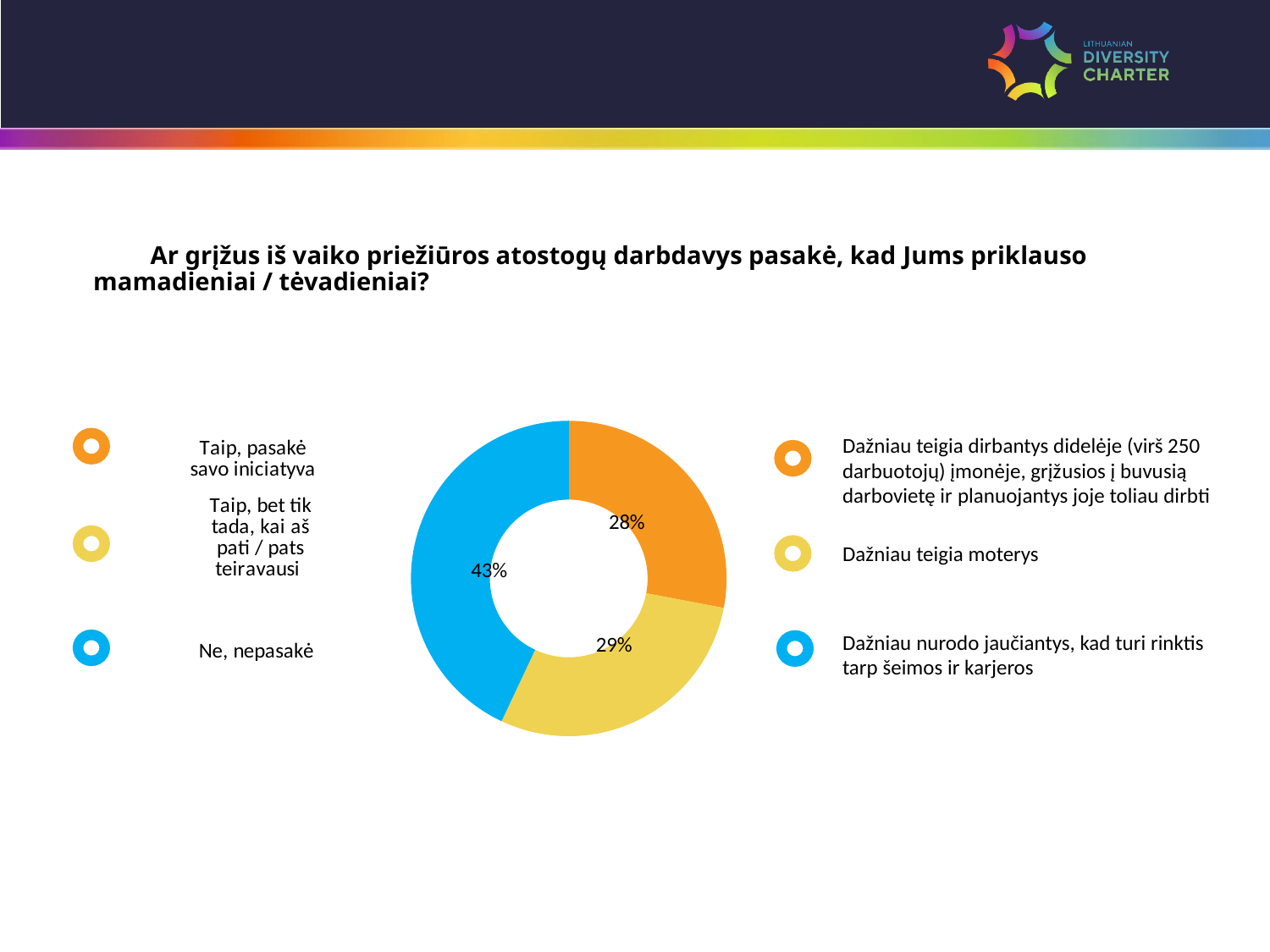
What is the difference in percentage points between "Ne, nepasakė" and "Taip, pasakė savo iniciatyva"? 15 percentage points What percentage of respondents answered "Ne, nepasakė"? 43% What percentage of respondents answered "Taip, pasakė savo iniciatyva"? 28% Which colour represents the "Taip, pasakė savo iniciatyva" category in the chart? Orange What is the combined share of the two "Taip" answers (28% and 29%)? 57% Which answer category has the smallest share of the chart? Taip, pasakė savo iniciatyva Which is larger: the share for "Ne, nepasakė" or the share for "Taip, bet tik tada, kai aš pati / pats teiravausi"? Ne, nepasakė What percentage of respondents answered "Taip, bet tik tada, kai aš pati / pats teiravausi"? 29% Which colour represents the "Ne, nepasakė" category in the chart? Blue Which answer category has the largest share of the chart? Ne, nepasakė How many slices does the donut chart have? 3 What kind of chart is shown on the slide? Donut (pie) chart